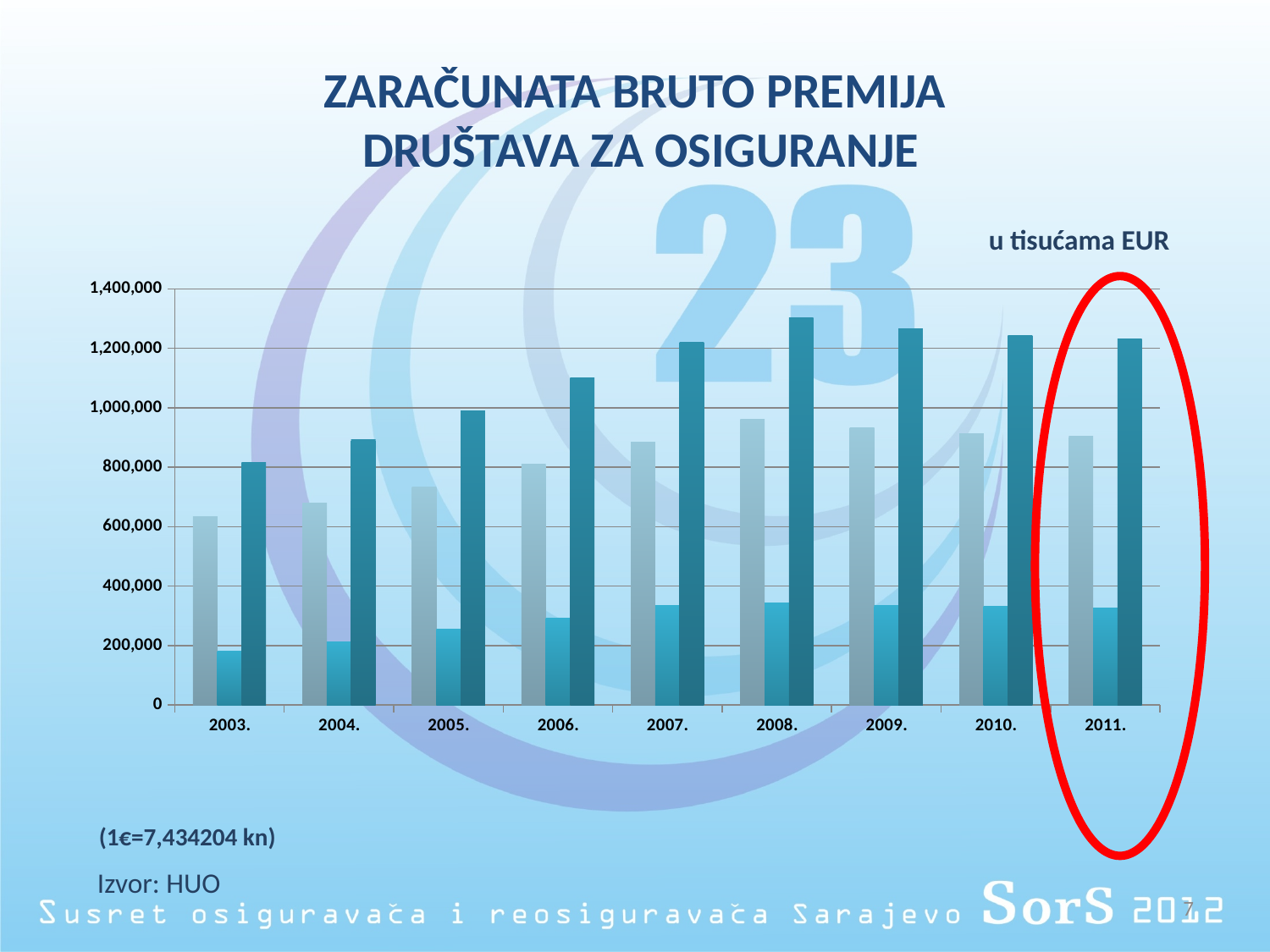
Do the dark teal bars rise or fall from 2003 to 2008? rise Is the value of the dark teal bar for 2008 greater or less than 1,200,000? greater In which year is the dark teal bar the shortest? 2003. Is the value of the light blue bar for 2011 greater or less than 400,000? less Which year's bars are circled in red on the chart? 2011. Is the value of the dark teal bar for 2003 greater or less than 1,000,000? less How many years are shown on the x axis of the chart? 9 Which year has the taller dark teal bar, 2006 or 2007? 2007. In which year is the dark teal bar the tallest? 2008. What kind of chart is shown on the slide? bar chart